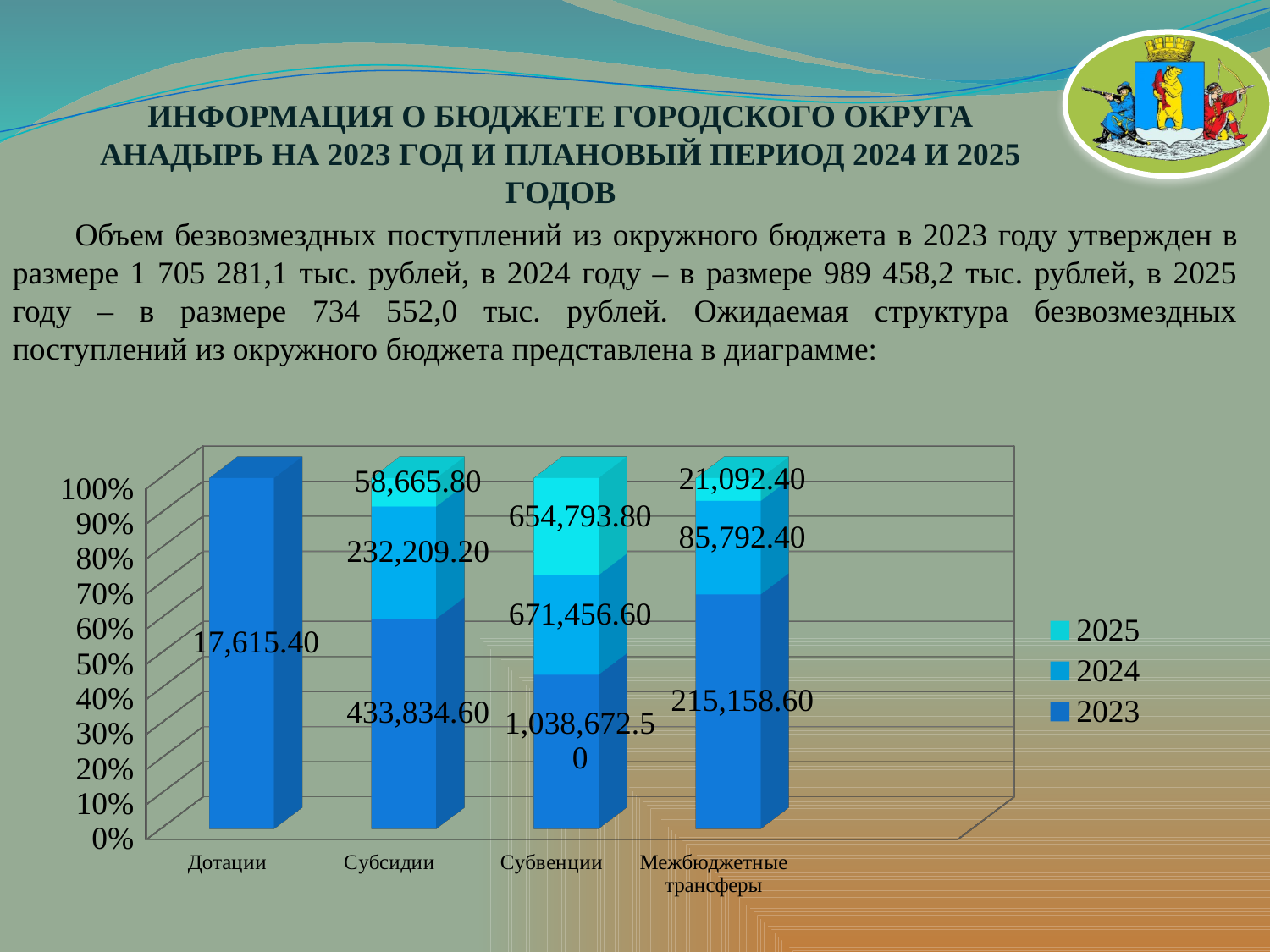
What is the 2025 value for Субсидии? 58,665.80 What is the 2023 value for Субвенции? 1,038,672.50 Which category has the highest 2023 value? Субвенции Which is larger: the 2024 value for Субвенции or the 2025 value for Субвенции? 2024 (671,456.60) What is the difference between the 2023 and 2024 values for Субсидии? 201,625.40 Which category has the lowest 2023 value? Дотации How many series does the legend list? 3 How many categories are shown on the x axis? 4 What is the total of the three labelled values in the Межбюджетные трансферы bar? 322,043.40 What is the 2023 value for Дотации? 17,615.40 What is the 2024 value for Межбюджетные трансферы? 85,792.40 What kind of chart is shown on the slide? Stacked bar chart